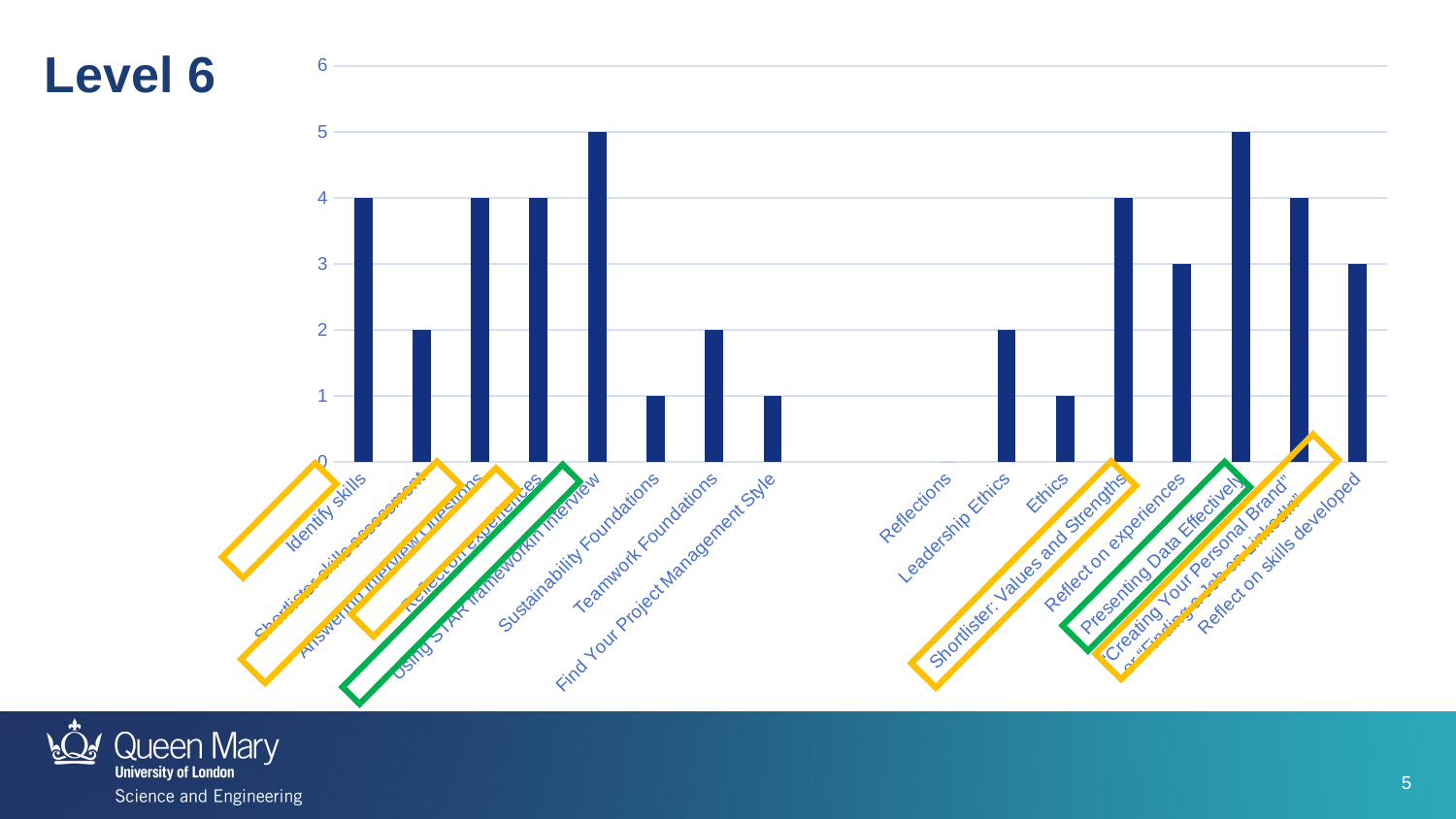
What is the value for Sustainability Foundations? 1 What is the value for Presenting Data Effectively? 5 What type of chart is shown on the slide? Bar chart What is the value for Teamwork Foundations? 2 What is the difference between the values for Using STAR framework in interview and Sustainability Foundations? 4 What is the value for Ethics? 1 What is the value for Using STAR framework in interview? 5 What is the value for Leadership Ethics? 2 Is the value for Presenting Data Effectively greater or less than 3? greater What is the value for Identify skills? 4 What is the highest value reached by any bar in the chart? 5 Which is larger, the value for Identify skills or the value for Teamwork Foundations? Identify skills